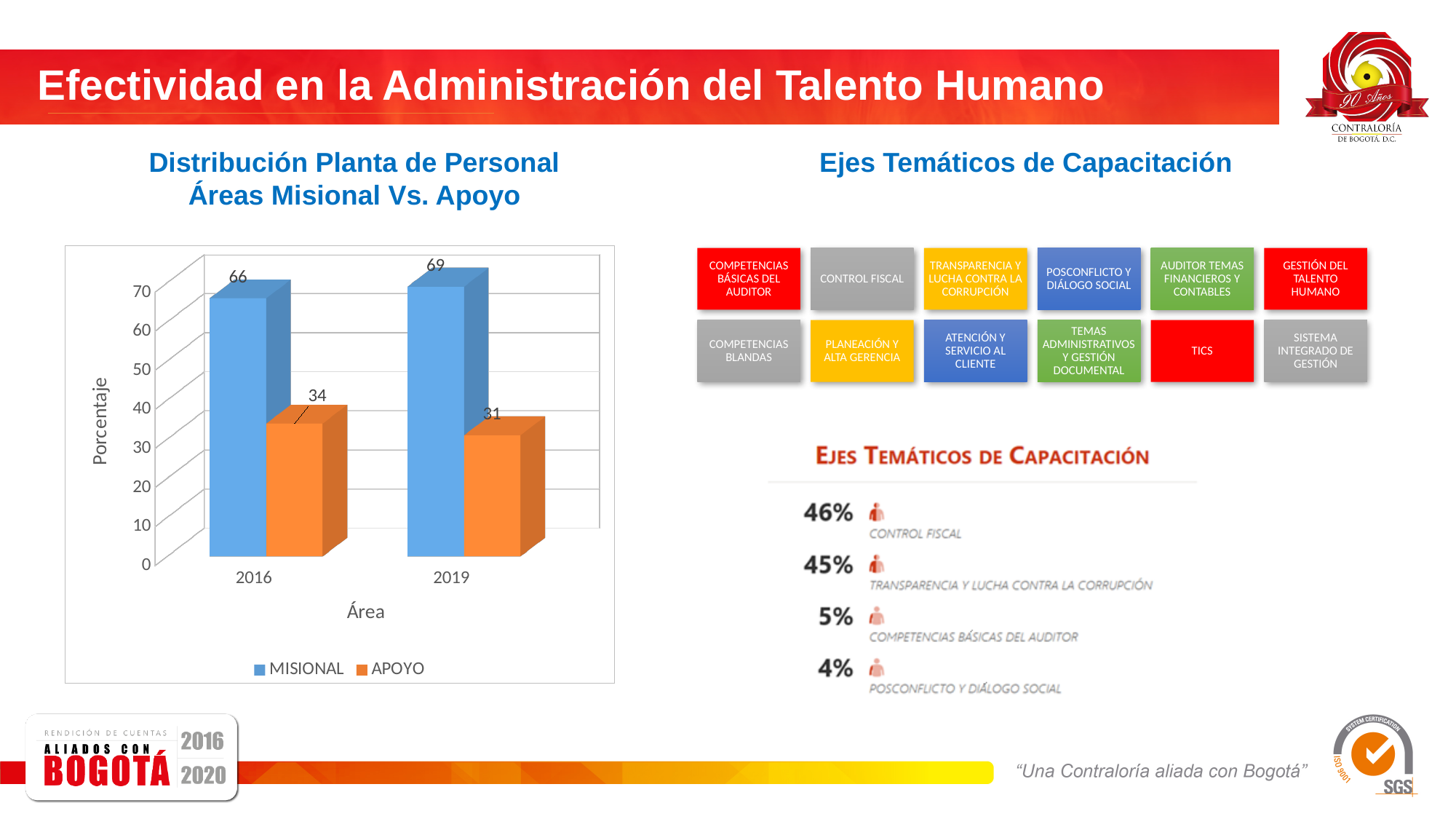
In the Distribución Planta de Personal chart, is the MISIONAL value for 2019 larger or smaller than the APOYO value for 2019? larger In the Distribución Planta de Personal chart, what is the difference between the MISIONAL values for 2019 and 2016? 3 In the Distribución Planta de Personal chart, which year has the lower APOYO value? 2019 How many series does the legend of the Distribución Planta de Personal chart list? 2 What is the APOYO value for 2016 in the Distribución Planta de Personal chart? 34 What is the y-axis label of the Distribución Planta de Personal chart? Porcentaje In the Distribución Planta de Personal chart, which year has the higher MISIONAL value? 2019 What is the MISIONAL value for 2016 in the Distribución Planta de Personal chart? 66 What is the MISIONAL value for 2019 in the Distribución Planta de Personal chart? 69 What is the APOYO value for 2019 in the Distribución Planta de Personal chart? 31 What kind of chart is the Distribución Planta de Personal chart? bar chart In the Distribución Planta de Personal chart, what is the difference between the MISIONAL and APOYO values for 2016? 32